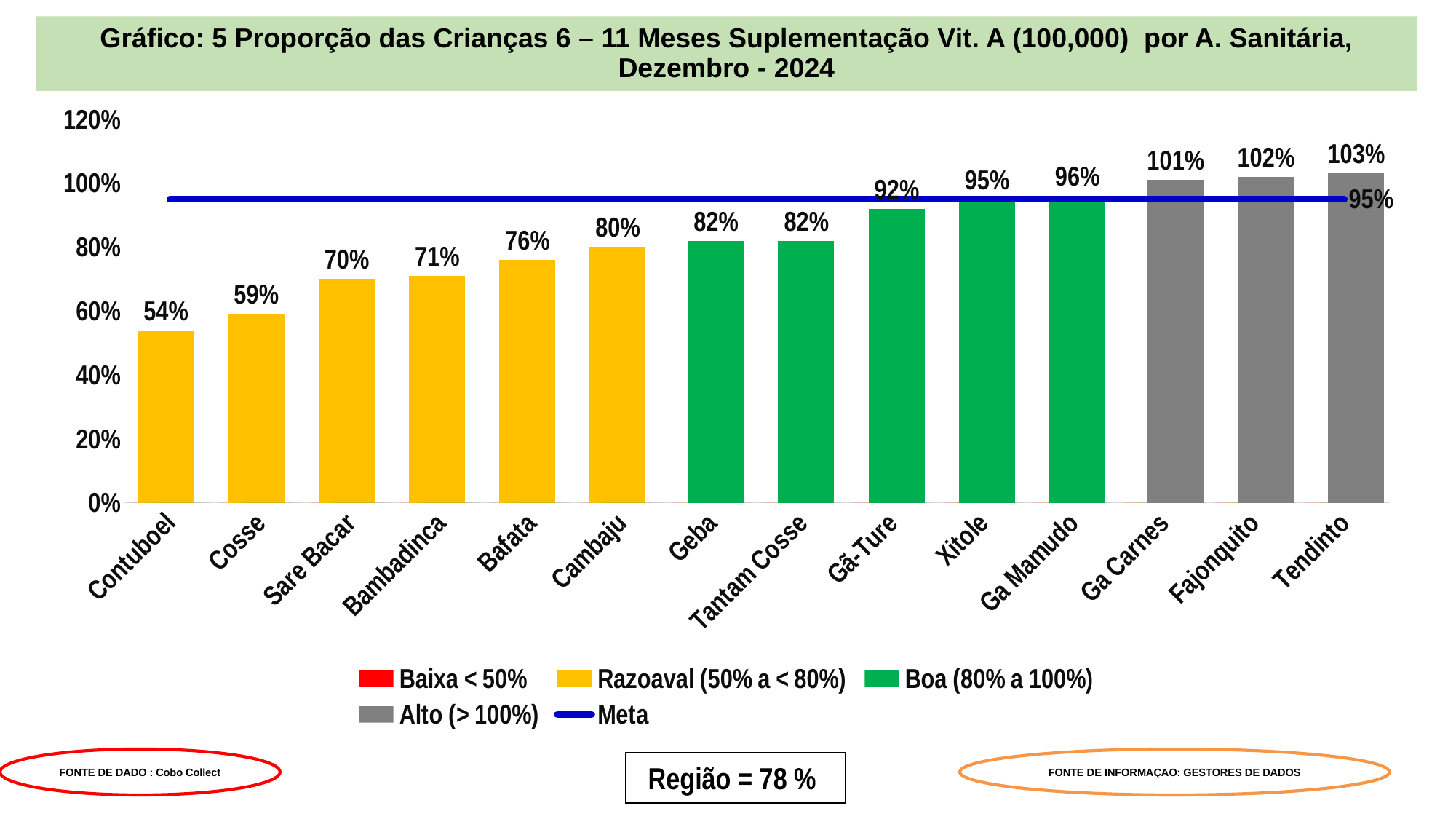
What is the difference between the values for Tendinto and Contuboel? 49% Which category has the highest value? Tendinto Do the bar values rise or fall from left to right along the x axis? rise What is the value for Gã-Ture? 92% Is the value for Cosse greater or less than 80%? less What value does the Meta line mark? 95% What is the value for Contuboel? 54% How many categories are shown on the x axis? 14 Which is larger, the value for Bafata or the value for Cambaju? Cambaju How many entries does the legend list? 5 Which category has the lowest value? Contuboel What kind of chart is this? bar chart